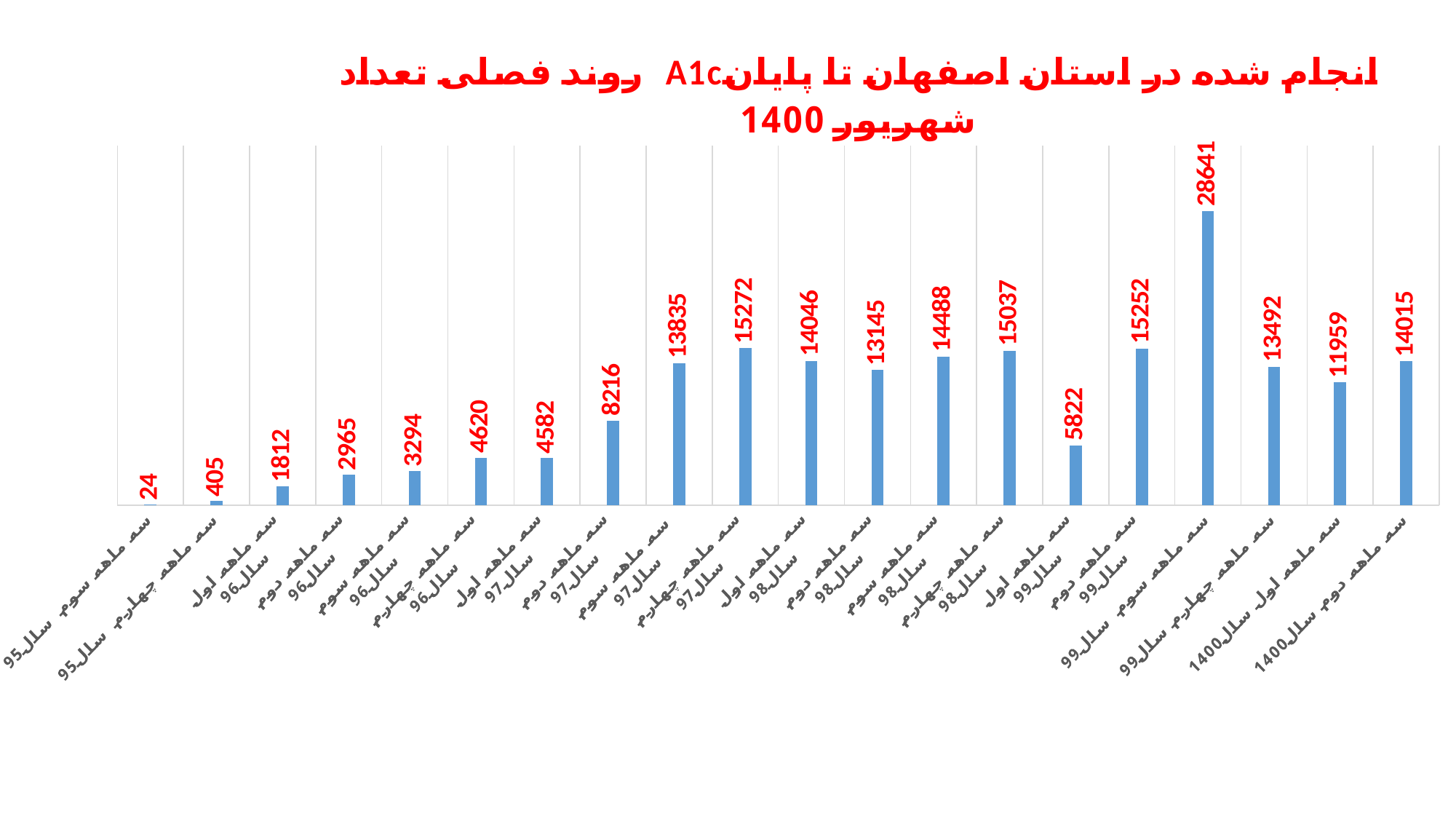
Which is larger, the value for سه ماهه چهارم سال97 or the value for سه ماهه اول سال98? سه ماهه چهارم سال97 What is the value for سه ماهه سوم سال99? 28641 How many bars are plotted in the chart? 20 What is the value for سه ماهه سوم سال95? 24 Do the values generally rise or fall from سه ماهه سوم سال95 to سه ماهه چهارم سال97? rise What is the difference between the values for سه ماهه اول سال1400 and سه ماهه دوم سال1400? 2056 What is the difference between the values for سه ماهه سوم سال99 and سه ماهه چهارم سال99? 15149 What kind of chart is shown on the slide? bar chart Which category has the highest value? سه ماهه سوم سال99 Which category has the lowest value? سه ماهه سوم سال95 What is the value for سه ماهه اول سال99? 5822 What is the value for سه ماهه دوم سال1400? 14015